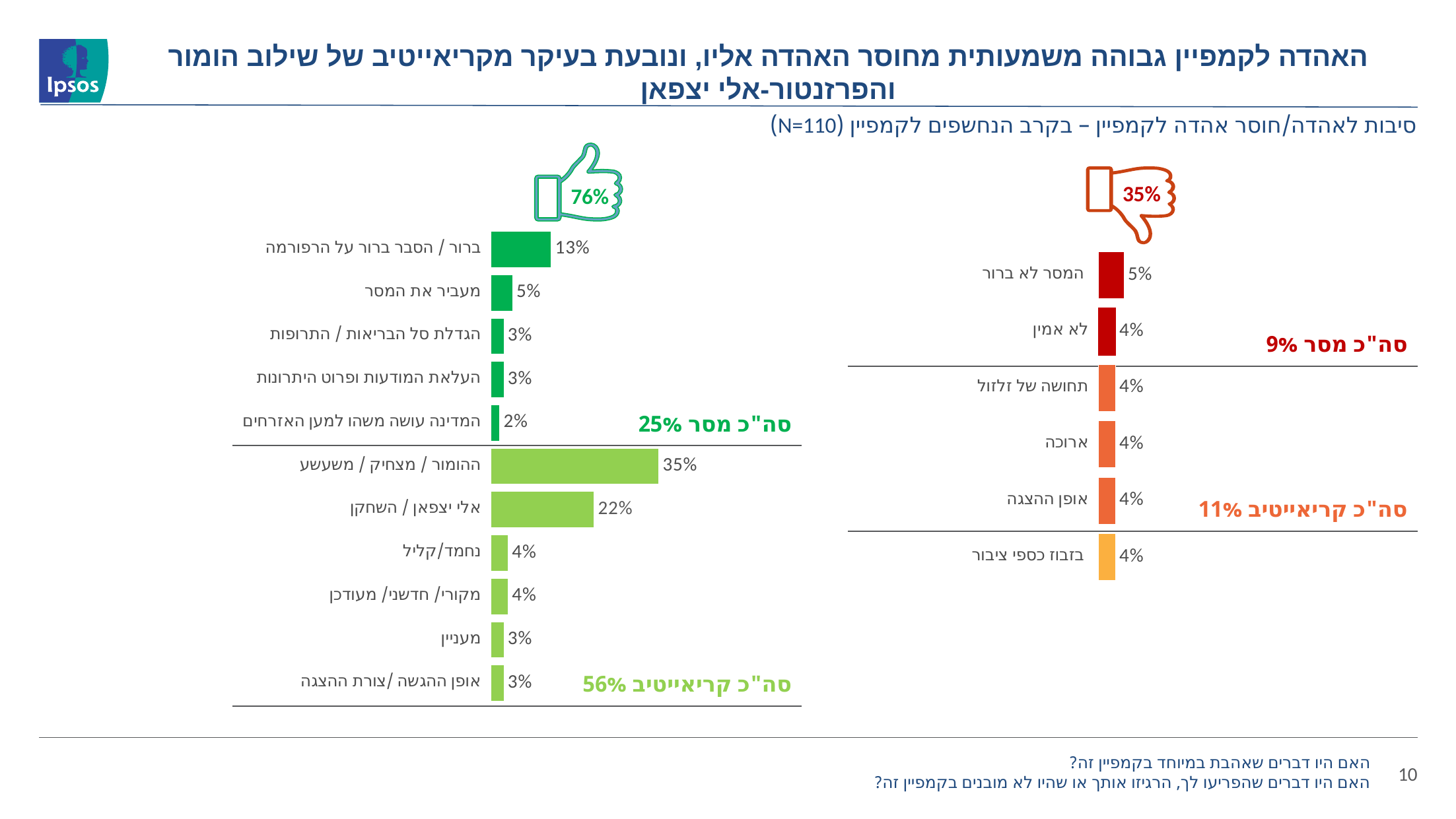
In the right-hand chart (reasons for disliking the campaign), what is the value for "המסר לא ברור"? 5% In the left-hand chart, which is larger: the value for "ברור / הסבר ברור על הרפורמה" or the value for "מעביר את המסר"? ברור / הסבר ברור על הרפורמה In the left-hand chart (reasons for liking the campaign), what is the value for "ההומור / מצחיק / משעשע"? 35% What type of chart is used on this slide? Bar chart In the left-hand chart (reasons for liking the campaign), what is the value for "ברור / הסבר ברור על הרפורמה"? 13% In the left-hand chart, what is the difference between the values for "ההומור / מצחיק / משעשע" and "אלי יצפאן / השחקן"? 13% In the right-hand chart (reasons for disliking the campaign), which category has the highest value? המסר לא ברור How many categories are plotted in the right-hand chart (reasons for disliking the campaign)? 6 How many categories are plotted in the left-hand chart (reasons for liking the campaign)? 11 In the left-hand chart (reasons for liking the campaign), which category has the lowest value? המדינה עושה משהו למען האזרחים In the left-hand chart (reasons for liking the campaign), what is the value for "אלי יצפאן / השחקן"? 22% In the left-hand chart (reasons for liking the campaign), which category has the highest value? ההומור / מצחיק / משעשע